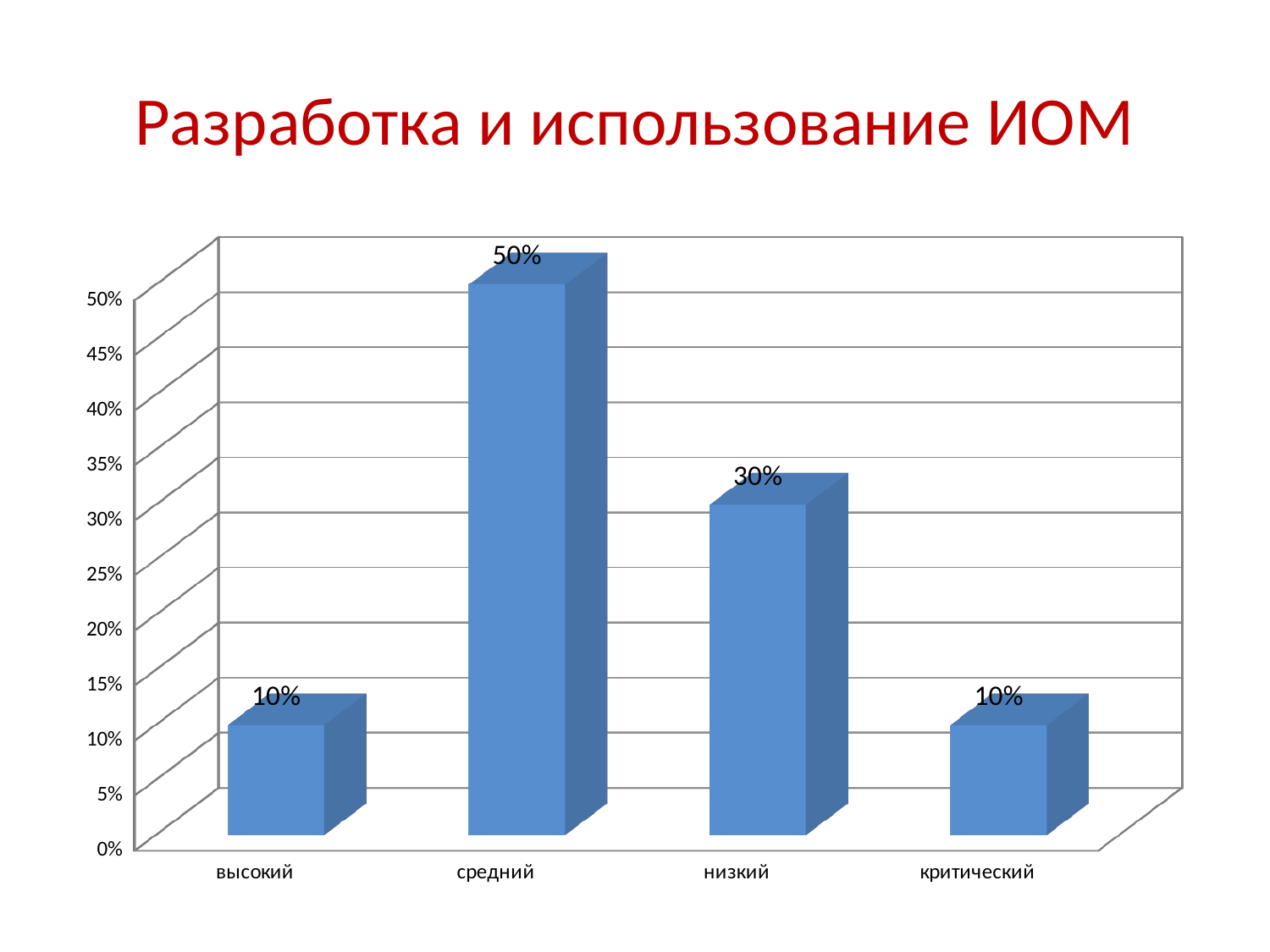
What is the difference between the values for средний and низкий? 20% What is the value for низкий? 30% What is the total of the values for высокий and критический? 20% Which is larger, the value for низкий or the value for высокий? низкий How many categories are shown on the x axis? 4 What kind of chart is shown on the slide? bar chart What is the value for высокий? 10% What is the difference between the values for низкий and критический? 20% Which category has the highest value? средний What is the value for критический? 10% What is the value for средний? 50% What is the title of the slide? Разработка и использование ИОМ